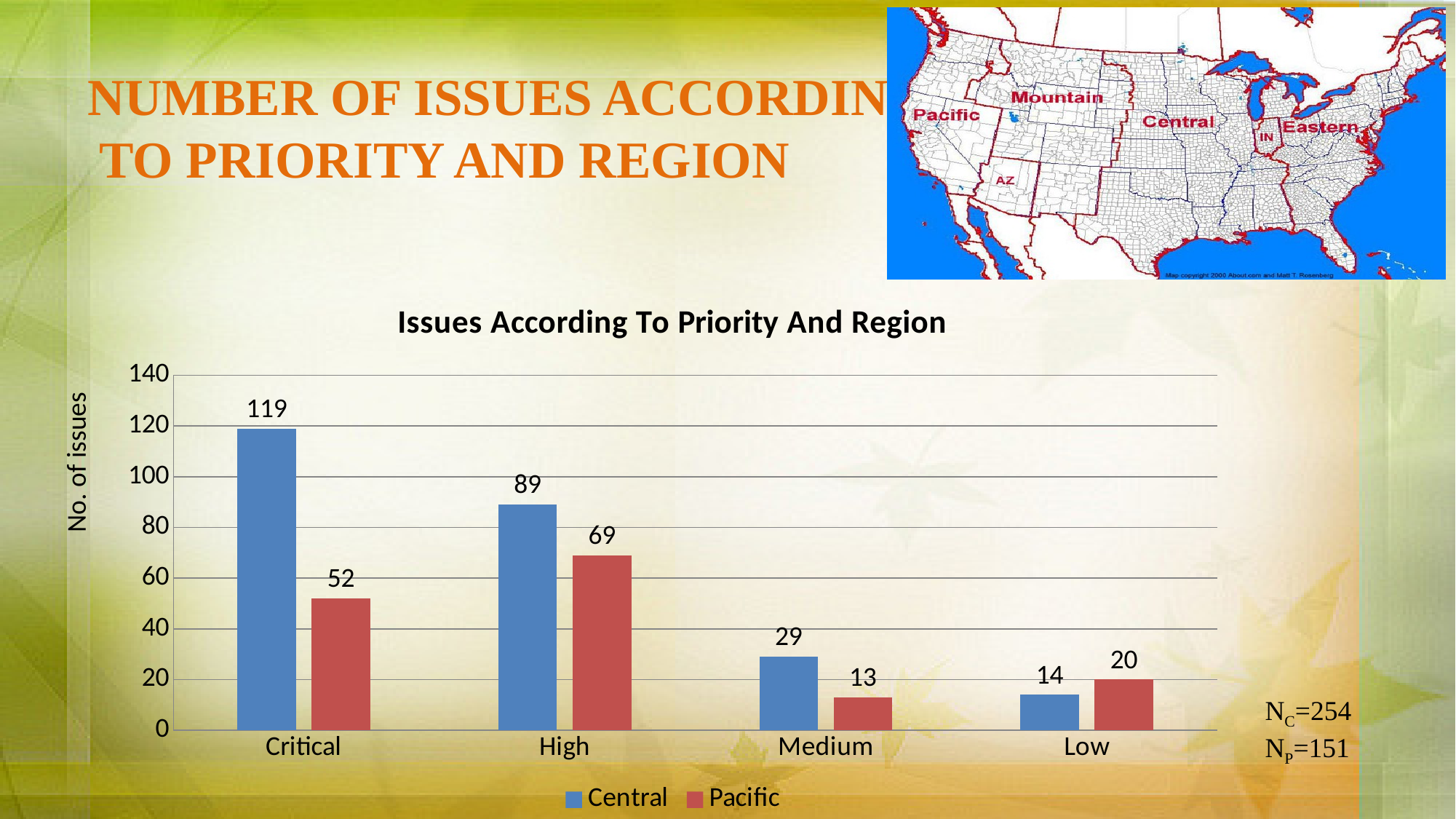
Which is larger for the Low priority, Central or Pacific? Pacific Is the value for Central in the High priority greater or less than 80? greater What is the number of issues for Pacific in the High priority? 69 Which priority category has the highest number of issues for Central? Critical What is the number of issues for Pacific in the Low priority? 20 What is the difference between the Central and Pacific values for the Critical priority? 67 What is the number of issues for Central in the Critical priority? 119 How many priority categories are shown on the x axis? 4 How many series does the legend list? 2 Which priority category has the lowest number of issues for Pacific? Medium What is the title of the chart? Issues According To Priority And Region What kind of chart is shown on the slide? Bar chart